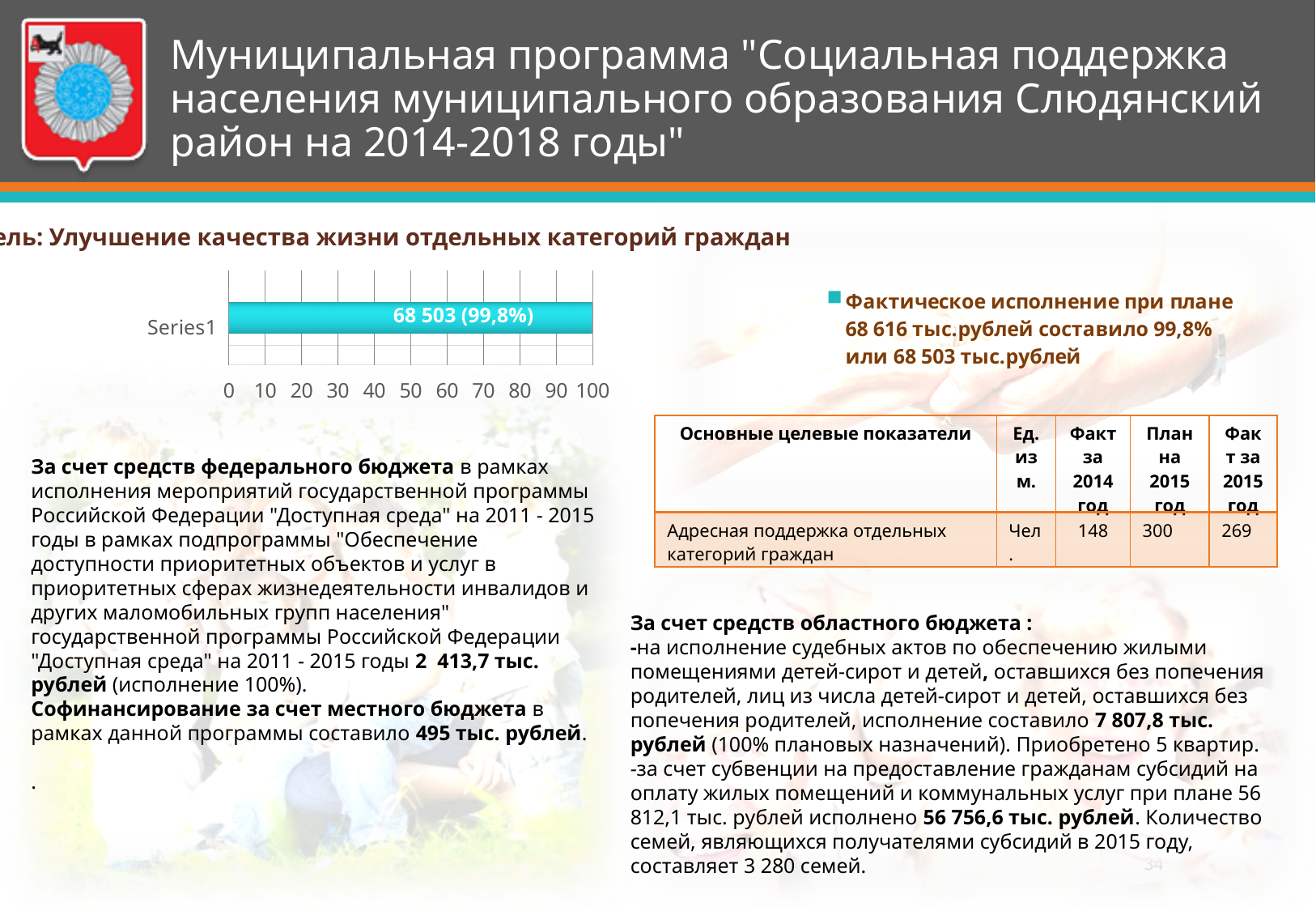
How many bars are plotted in the chart? 1 What data label is printed on the bar in the chart? 68 503 (99,8%) What kind of chart is shown on the slide? bar chart What is the maximum value shown on the chart's x axis? 100 How many series does the chart legend list? 1 Is the bar for Series1 greater or less than 90 on the x axis? greater What percentage is shown in parentheses in the bar's data label? 99,8% What is the category label shown on the vertical axis of the chart? Series1